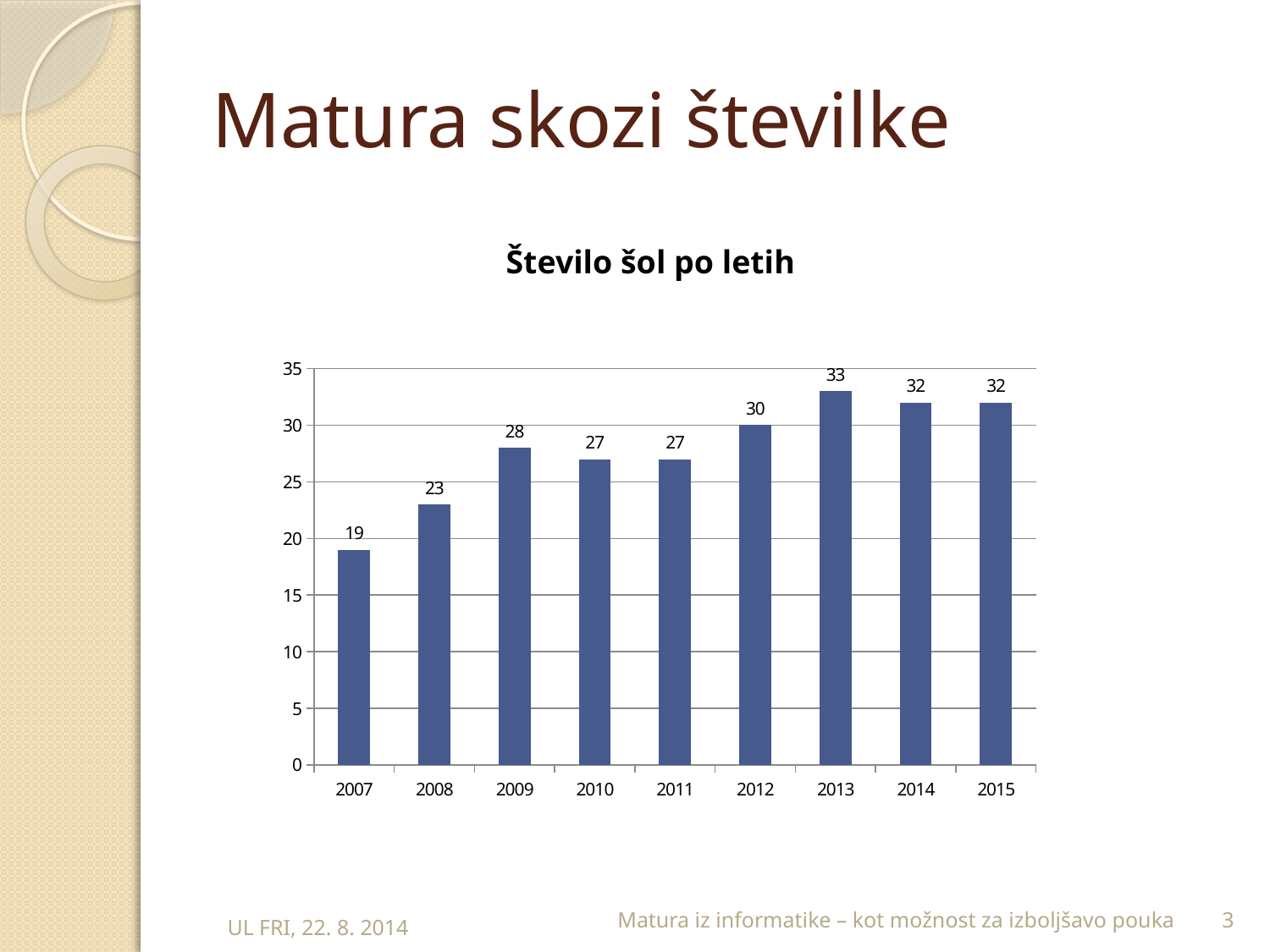
Which year has the lowest value? 2007 How many years are shown on the x axis? 9 What is the difference between the values for 2013 and 2007? 14 Is the value for 2011 greater or less than 25? greater Which is larger, the value for 2009 or the value for 2010? 2009 What kind of chart is this? bar chart Which year has the highest value? 2013 What is the value for 2012? 30 What is the difference between the values for 2008 and 2007? 4 What is the value for 2007? 19 What is the value for 2009? 28 What is the title of the chart? Število šol po letih